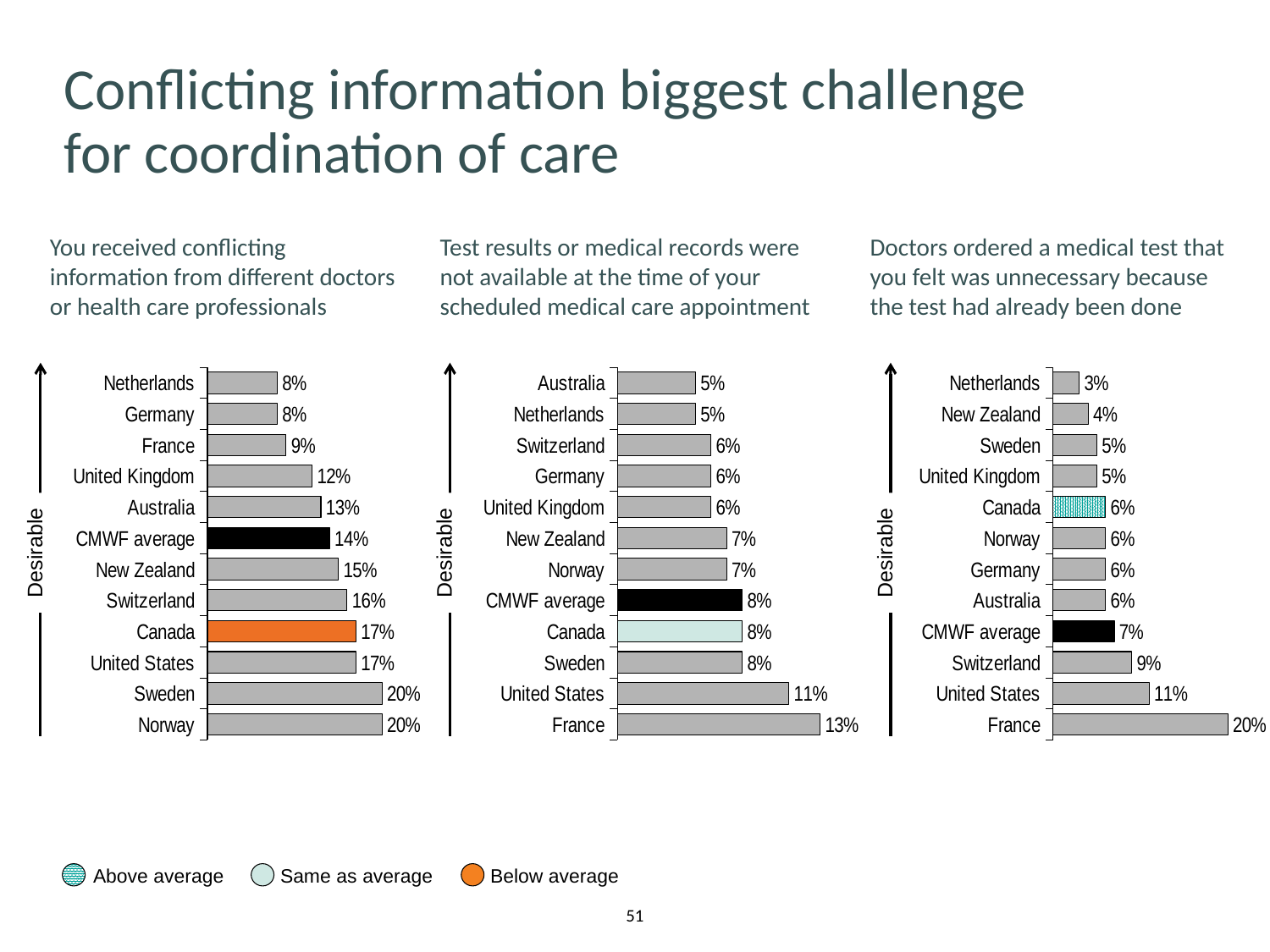
In the middle chart (test results or medical records not available), which country has the highest value? France In the left chart (conflicting information from different doctors), which is larger, the value for Australia or the value for Switzerland? Switzerland According to the legend at the bottom of the slide, what does the orange colour indicate? Below average In the right chart (doctors ordered an unnecessary test), which country has the lowest value? Netherlands In the middle chart (test results or medical records not available), what is the difference between France and the CMWF average? 5% In the left chart (conflicting information from different doctors), what is the value for Canada? 17% In the left chart (conflicting information from different doctors), what is the value for the CMWF average? 14% In the right chart (doctors ordered an unnecessary test), what is the value for France? 20% In the right chart (doctors ordered an unnecessary test), what is the difference between France and the United States? 9% In the middle chart (test results or medical records not available), what is the value for the United States? 11% What type of chart is used for the three charts on the slide? Bar chart How many countries or categories are plotted in the left chart (conflicting information from different doctors)? 12